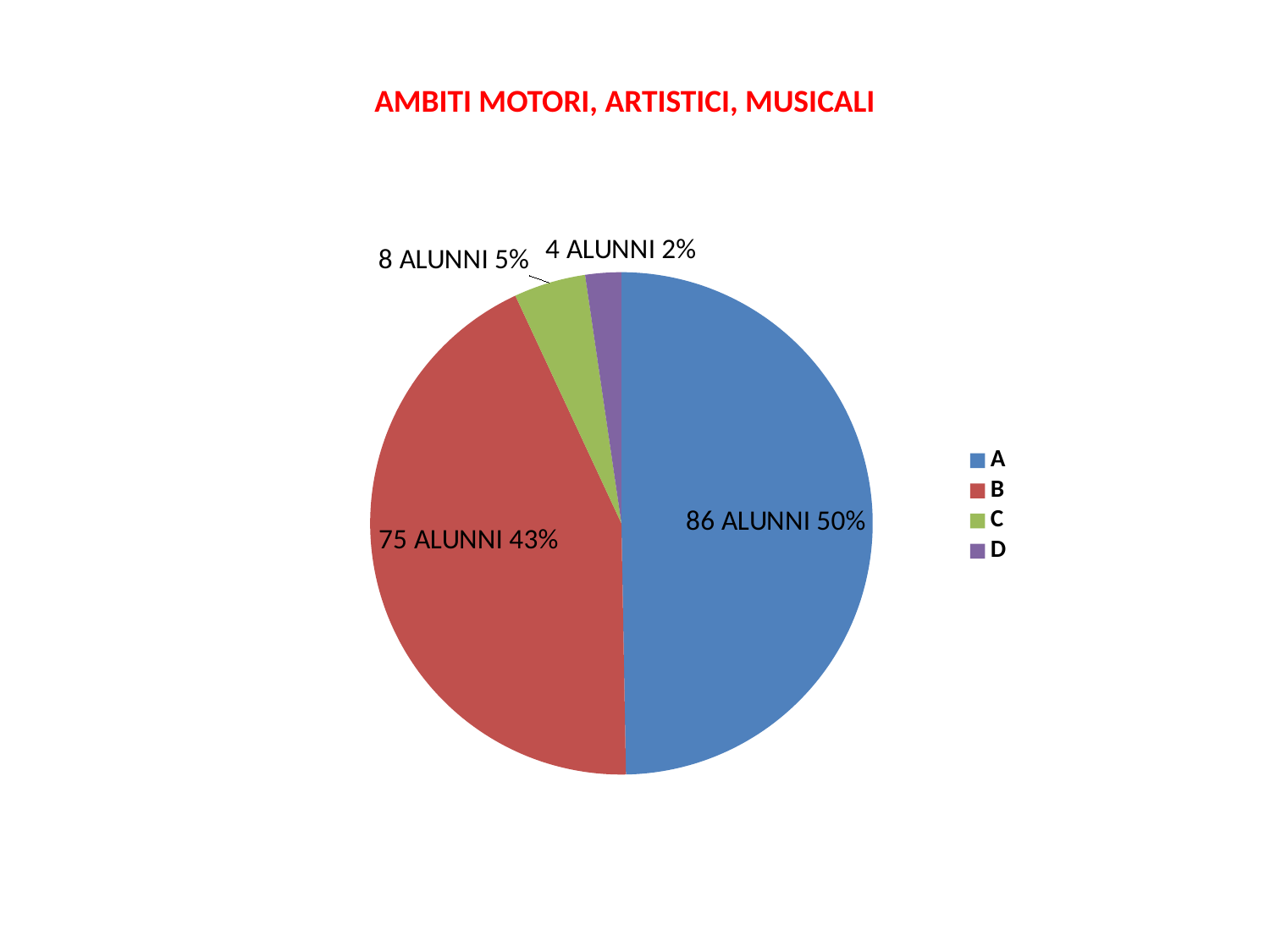
How many alunni are in category B? 75 How many slices does the pie chart have? 4 Which category has the largest slice? A What share of the pie does category B represent? 43% How many alunni are in category D? 4 What is the title of the chart? AMBITI MOTORI, ARTISTICI, MUSICALI How many entries does the legend list? 4 What is the difference in alunni between category A and category B? 11 Which category has the smallest slice? D How many alunni are in category C? 8 How many alunni are in category A? 86 What type of chart is shown on the slide? pie chart